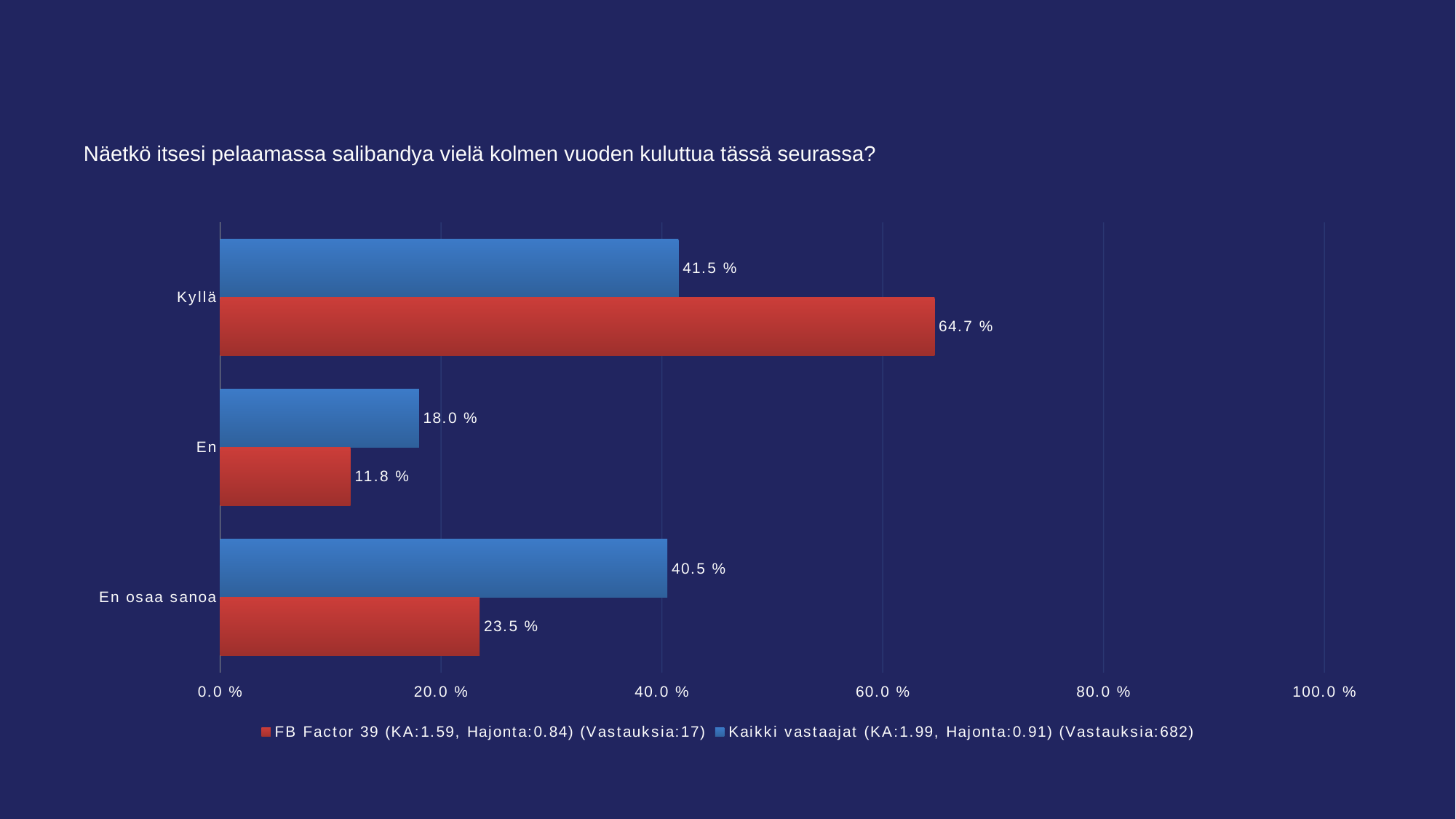
How many series does the legend list? 2 What is the value for En osaa sanoa in the Kaikki vastaajat series? 40.5 % How many categories are shown on the chart? 3 What kind of chart is shown on the slide? Bar chart Is the FB Factor 39 value for Kyllä greater or less than 60.0 %? greater What is the value for En in the FB Factor 39 series? 11.8 % What is the value for Kyllä in the Kaikki vastaajat series? 41.5 % Which category has the lowest value in the Kaikki vastaajat series? En What is the difference between the FB Factor 39 and Kaikki vastaajat values for Kyllä? 23.2 % Which series has the larger value for En osaa sanoa? Kaikki vastaajat What is the value for Kyllä in the FB Factor 39 series? 64.7 % Which category has the highest value in the FB Factor 39 series? Kyllä